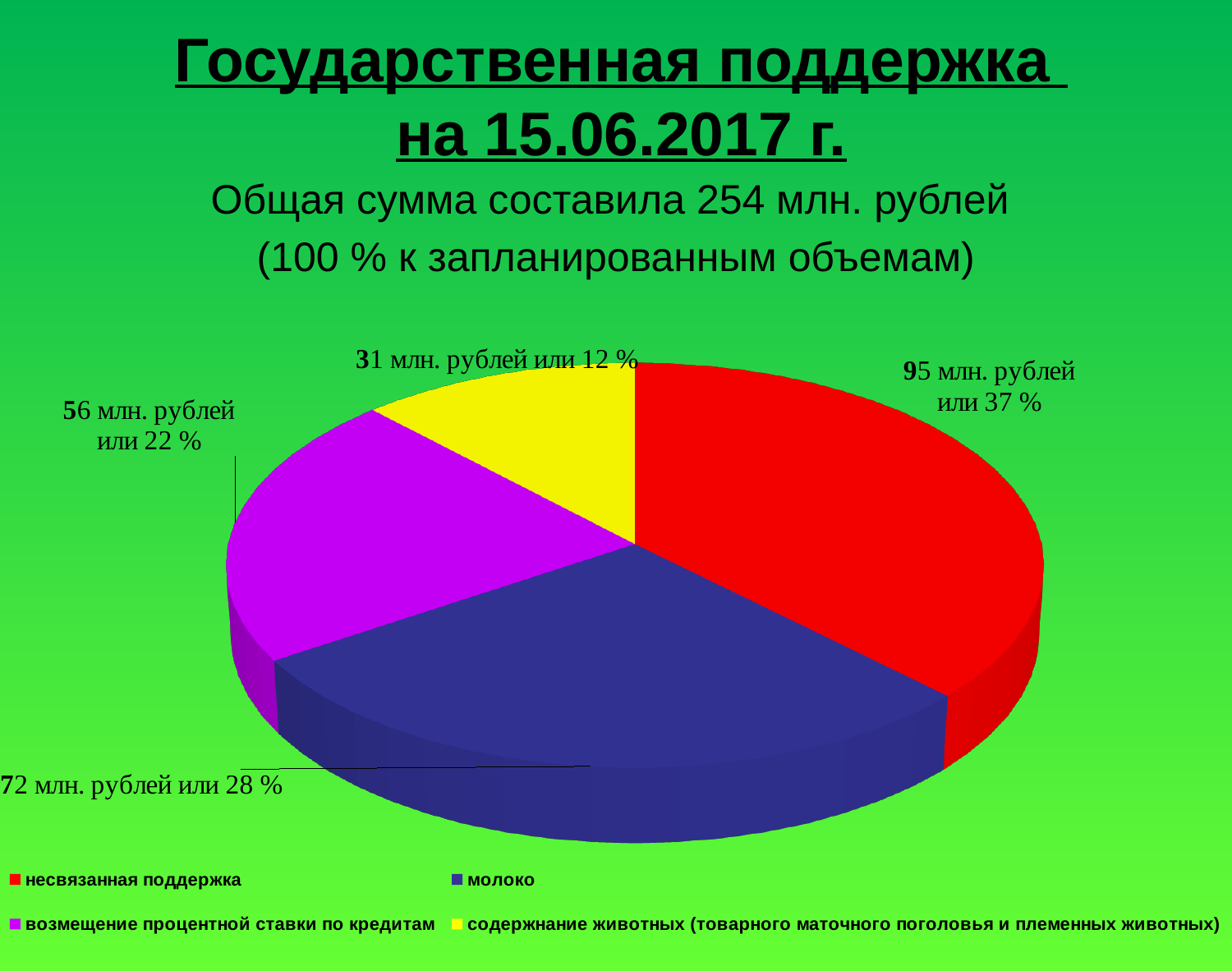
What value is shown for the 'содержание животных' slice? 31 млн. рублей или 12 % How many slices does the pie chart have? 4 What is the difference in млн. рублей between 'несвязанная поддержка' and 'молоко'? 23 млн. рублей What value is shown for the 'возмещение процентной ставки по кредитам' slice? 56 млн. рублей или 22 % What value is shown for the 'молоко' slice? 72 млн. рублей или 28 % Which is larger, the 'возмещение процентной ставки по кредитам' slice or the 'содержание животных' slice? возмещение процентной ставки по кредитам What value is shown for the 'несвязанная поддержка' slice? 95 млн. рублей или 37 % Which category has the smallest share of the pie? содержание животных (товарного маточного поголовья и племенных животных) What colour is the 'молоко' slice in the pie chart? blue What share of the pie does the 'молоко' slice represent? 28 % Which category has the largest share of the pie? несвязанная поддержка What kind of chart is shown on the slide? pie chart